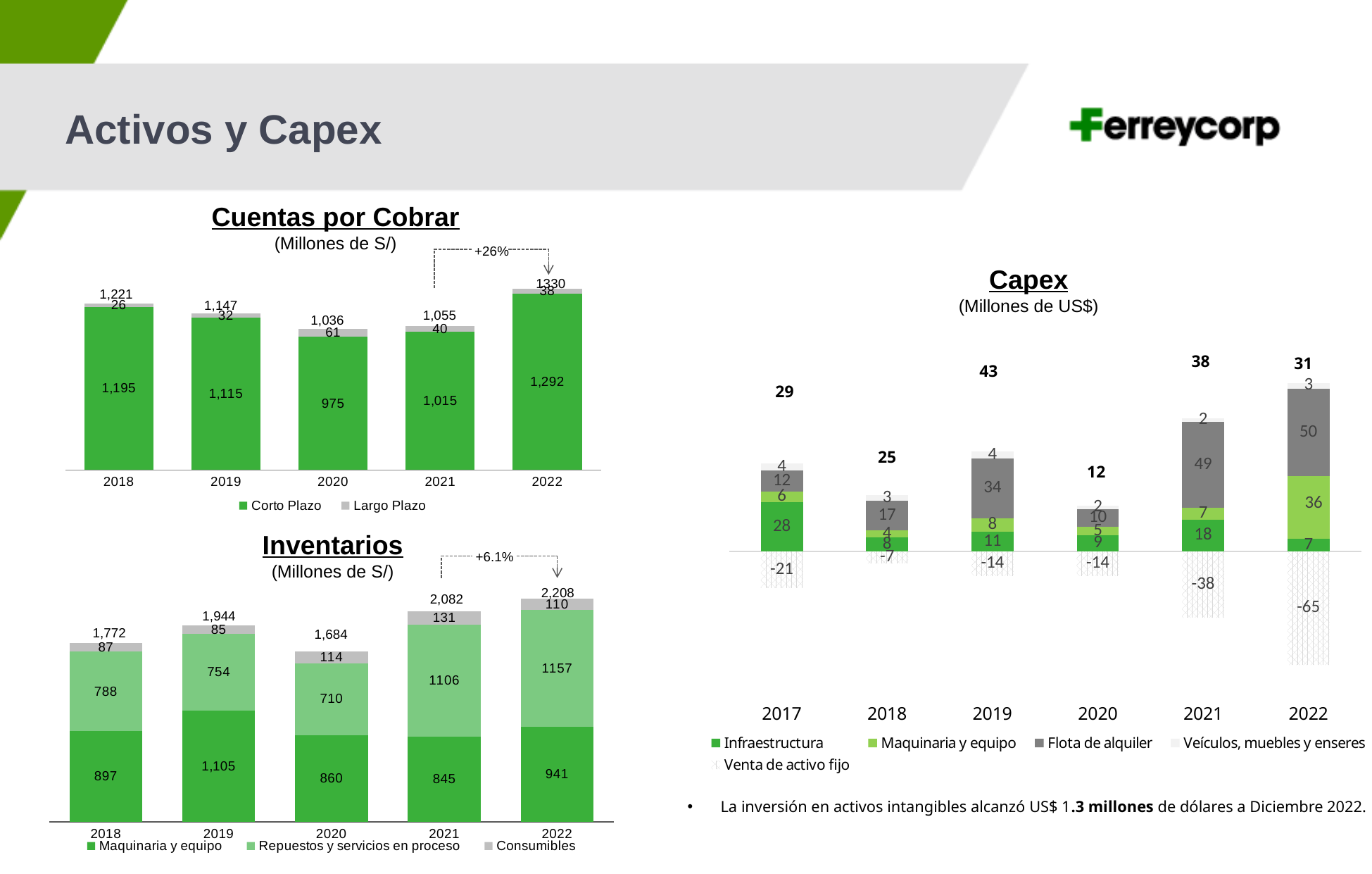
In the Capex chart, what is the Venta de activo fijo value for 2022? -65 In the Cuentas por Cobrar chart, what is the Largo Plazo value for 2020? 61 In the Cuentas por Cobrar chart, what is the Corto Plazo value for 2022? 1,292 In the Inventarios chart, what is the total for 2022? 2,208 In the Capex chart, is the Maquinaria y equipo value for 2022 larger or smaller than the Infraestructura value for 2022? larger In the Cuentas por Cobrar chart, what is the difference between the Corto Plazo values for 2022 and 2021? 277 In the Capex chart, which year has the highest total Capex? 2019 In the Inventarios chart, what is the Repuestos y servicios en proceso value for 2021? 1106 In the Inventarios chart, how many series does the legend list? 3 In the Inventarios chart, which year has the highest Maquinaria y equipo value? 2019 In the Capex chart, what is the Flota de alquiler value for 2021? 49 In the Cuentas por Cobrar chart, which year has the lowest total? 2020